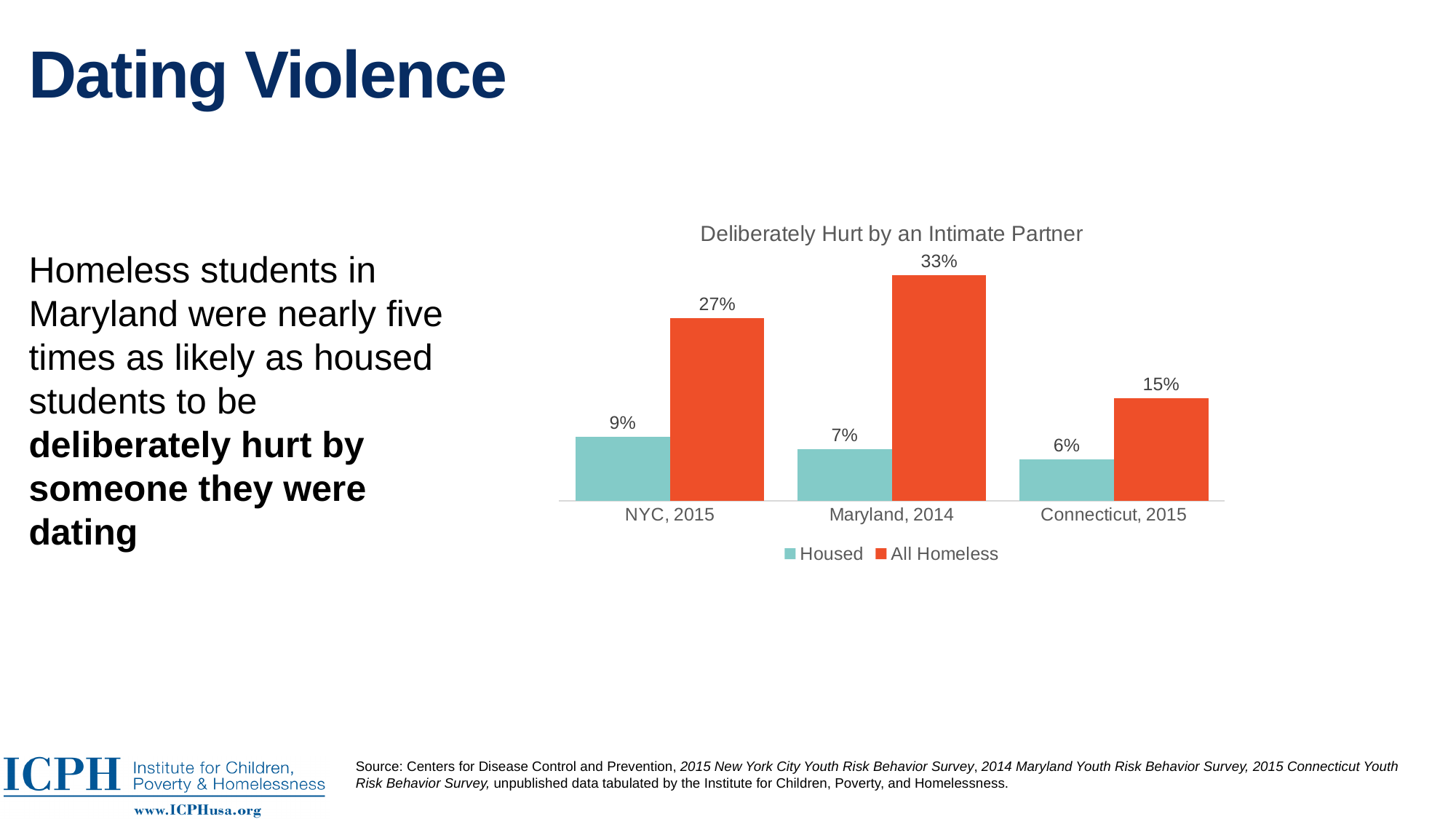
What is the difference between the All Homeless values for NYC, 2015 and Connecticut, 2015? 12% Which is larger: the Housed value for NYC, 2015 or the Housed value for Maryland, 2014? NYC, 2015 How many series does the legend list? 2 What is the value for Housed in Connecticut, 2015? 6% What is the title of the chart? Deliberately Hurt by an Intimate Partner Which category has the lowest Housed value? Connecticut, 2015 What is the value for Housed in NYC, 2015? 9% What is the value for All Homeless in Maryland, 2014? 33% What is the value for All Homeless in Connecticut, 2015? 15% How many categories are shown on the x axis? 3 What is the difference between the All Homeless and Housed values in Maryland, 2014? 26% Which category has the highest All Homeless value? Maryland, 2014